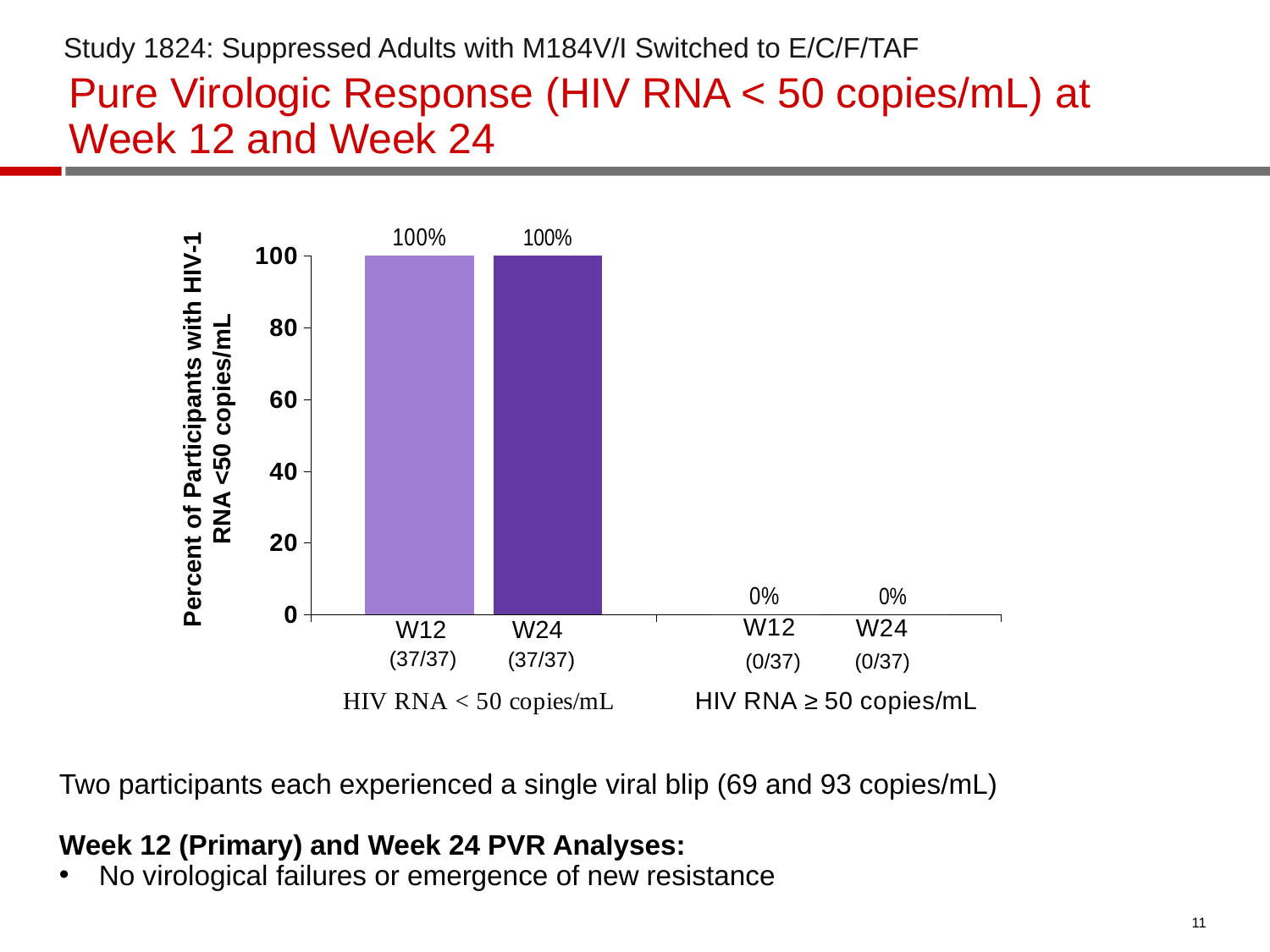
What is the value for W12 in the HIV RNA ≥ 50 copies/mL group? 0% What is the value for W24 in the HIV RNA ≥ 50 copies/mL group? 0% What is the value for W12 in the HIV RNA < 50 copies/mL group? 100% What is the difference between the W12 value in the HIV RNA < 50 copies/mL group and the W12 value in the HIV RNA ≥ 50 copies/mL group? 100% What is the value for W24 in the HIV RNA < 50 copies/mL group? 100% What is the label of the y axis? Percent of Participants with HIV-1 RNA <50 copies/mL What kind of chart is shown on the slide? bar chart What is the maximum value shown on the y axis? 100 How many participants out of the total had HIV RNA < 50 copies/mL at W24? 37/37 How many participants out of the total had HIV RNA ≥ 50 copies/mL at W12? 0/37 Which is larger: the W24 value for HIV RNA < 50 copies/mL or the W24 value for HIV RNA ≥ 50 copies/mL? HIV RNA < 50 copies/mL